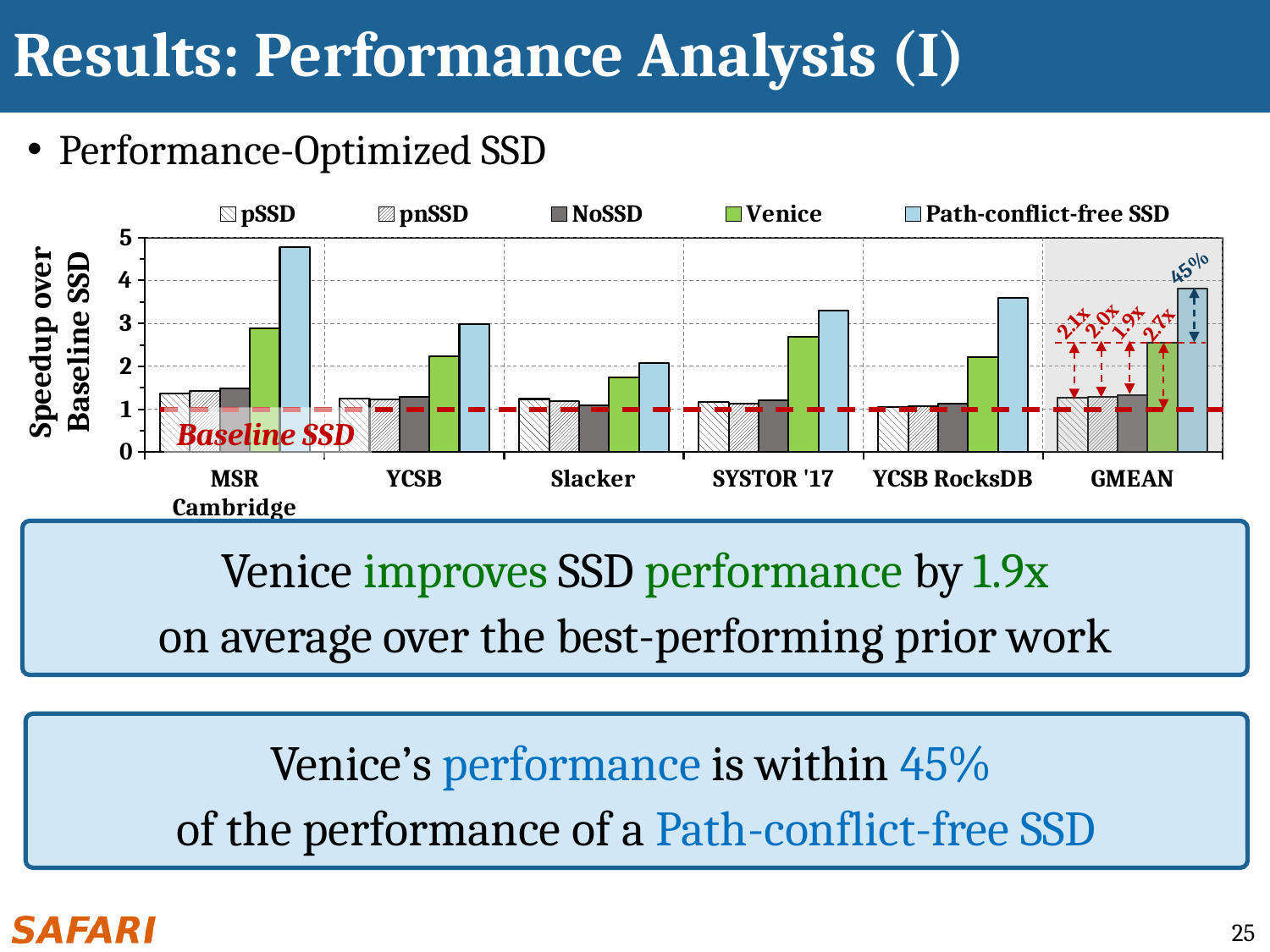
For which workload is the Venice bar the lowest? Slacker Is the Path-conflict-free SSD value for YCSB RocksDB greater or less than 3? greater How many series does the chart legend list? 5 What percentage is annotated above the GMEAN bars between Venice and Path-conflict-free SSD? 45% Is the Venice value for SYSTOR '17 greater or less than 2? greater How many workload categories are shown along the x axis of the chart? 6 Is the Venice value for Slacker greater or less than 2? less What kind of chart is shown on the slide? bar chart At what y-axis value is the dashed 'Baseline SSD' line drawn? 1 Which series has the tallest bar in every workload category? Path-conflict-free SSD For SYSTOR '17, which is larger: the Venice bar or the NoSSD bar? Venice